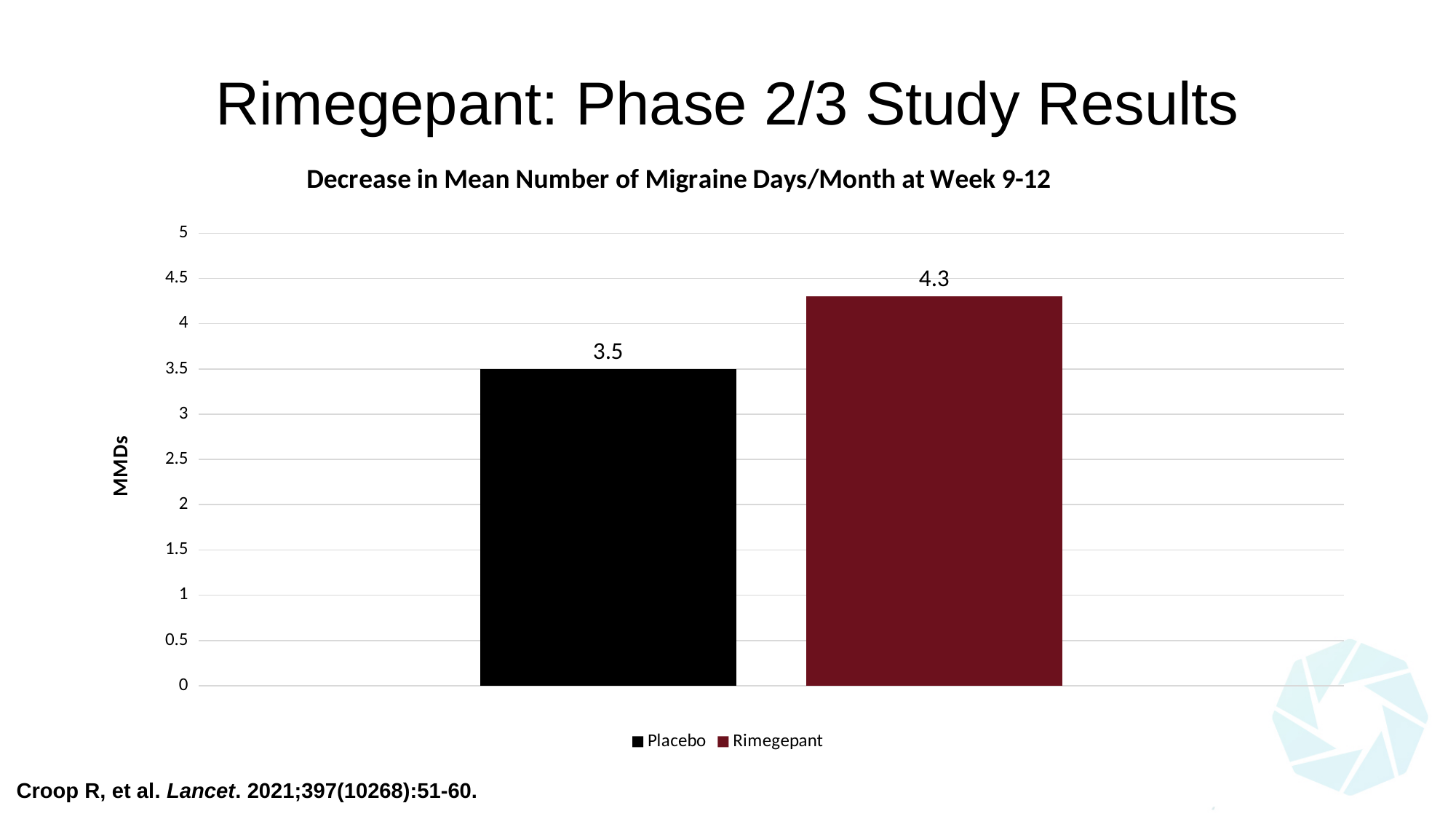
Which group shows the larger decrease in mean migraine days per month? Rimegepant Is the value for Rimegepant greater or less than 4? greater What is the label on the vertical axis of the chart? MMDs What is the difference between the Rimegepant and Placebo values? 0.8 How many entries does the legend list? 2 Which group shows the smaller decrease in mean migraine days per month? Placebo What is the value for Rimegepant? 4.3 What kind of chart is shown on the slide? Bar chart How many bars are plotted in the chart? 2 Which is larger, the value for Placebo or the value for Rimegepant? Rimegepant Is the value for Placebo greater or less than 4? less What is the value for Placebo? 3.5